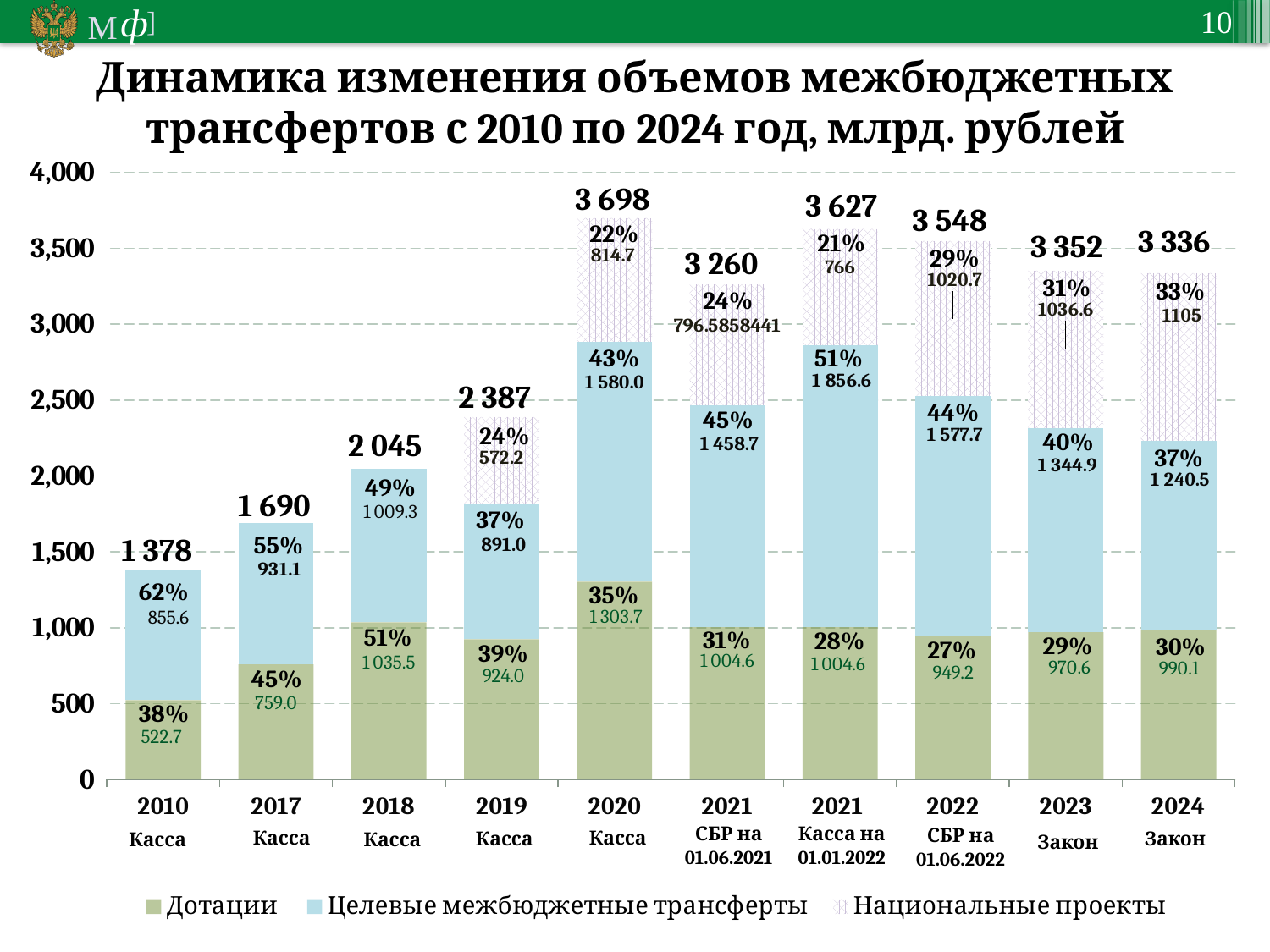
How many series does the legend list? 3 What type of chart is shown on the slide? stacked bar chart What is the value of Национальные проекты for 2024 (Закон)? 1105 What percentage share of the 2023 (Закон) bar is Национальные проекты? 31% Which year has the lowest total value? 2010 What is the value of Целевые межбюджетные трансферты for 2021 (Касса на 01.01.2022)? 1 856.6 Which year has the highest total value? 2020 What is the difference between the total for 2020 (Касса) and the total for 2010 (Касса)? 2 320 What is the total value printed above the bar for 2020 (Касса)? 3 698 How many bars (categories) are plotted on the chart? 10 What is the value of Дотации for 2010 (Касса)? 522.7 Which is larger: Дотации for 2018 (Касса) or Дотации for 2019 (Касса)? 2018 (Касса)